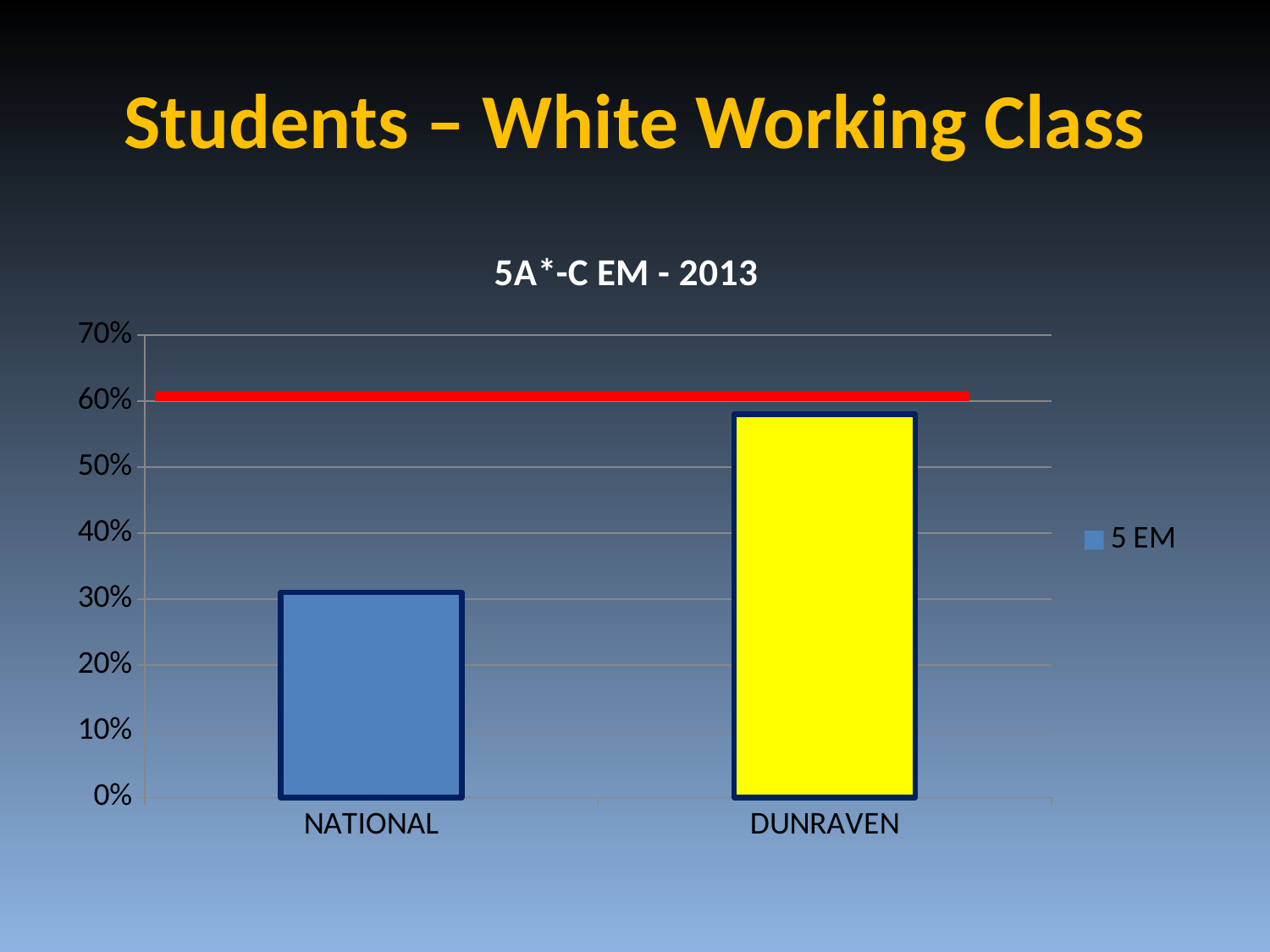
What is the title of the chart? 5A*-C EM - 2013 Is the value for NATIONAL greater or less than 40%? less Is the value for NATIONAL greater or less than 20%? greater Which category has the highest value? DUNRAVEN How many series does the legend list? 1 How many categories are plotted on the x axis? 2 Which category has the lowest value? NATIONAL What kind of chart is shown on the slide? bar chart Which is larger, the value for NATIONAL or the value for DUNRAVEN? DUNRAVEN Is the value for DUNRAVEN greater or less than 50%? greater What series name is shown in the legend? 5 EM